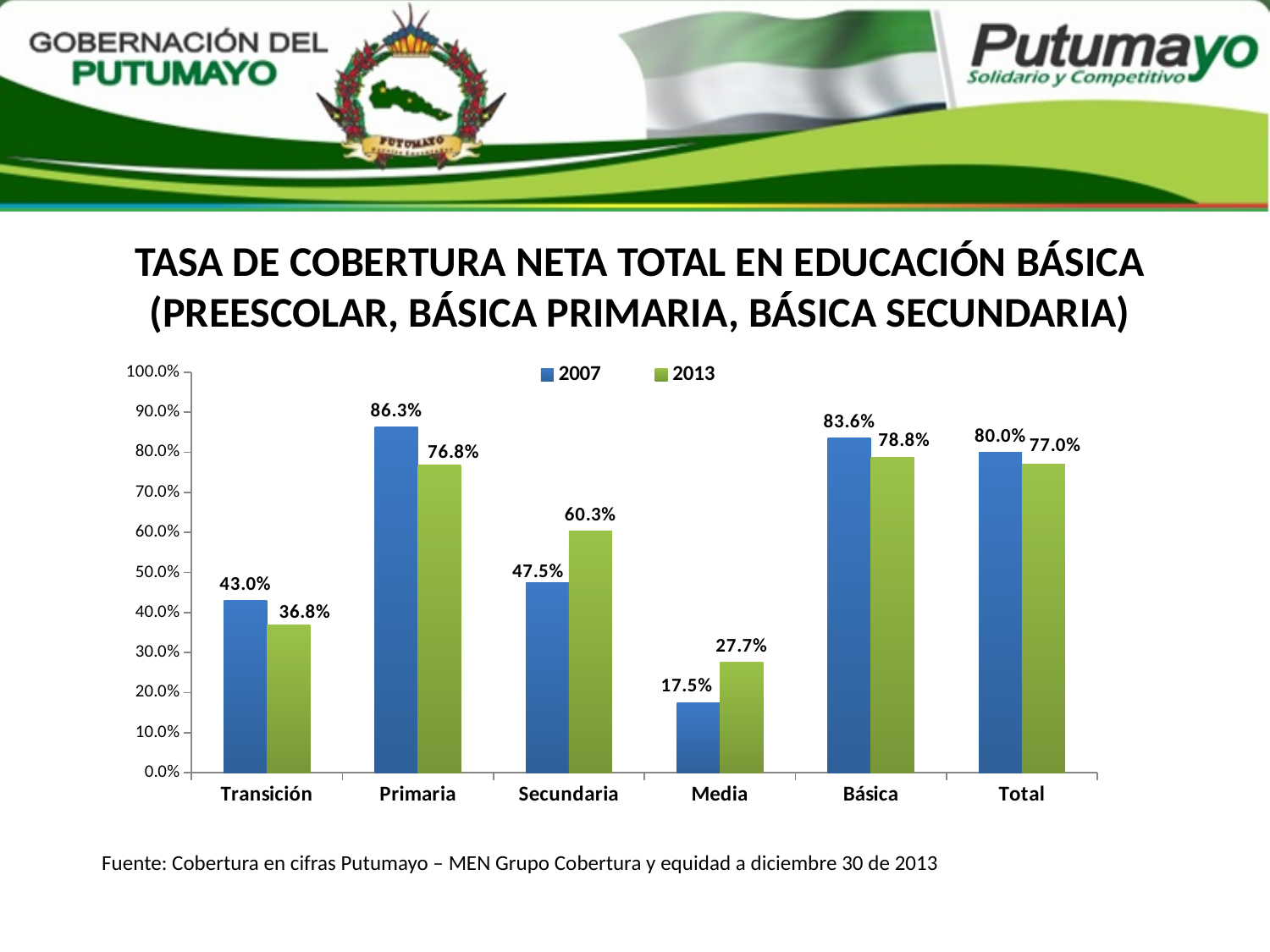
How many categories are shown on the x axis? 6 What colour are the bars for the 2013 series? green What is the difference between the 2007 and 2013 values for Transición? 6.2% What kind of chart is shown on the slide? bar chart Which category has the lowest 2013 value? Media Is the 2007 value for Básica greater or less than 80.0%? greater Which category has the highest 2007 value? Primaria What is the 2013 value for Secundaria? 60.3% What is the 2007 value for Primaria? 86.3% Which is larger for Secundaria, the 2007 value or the 2013 value? 2013 What is the 2013 value for Media? 27.7% How many series does the legend list? 2